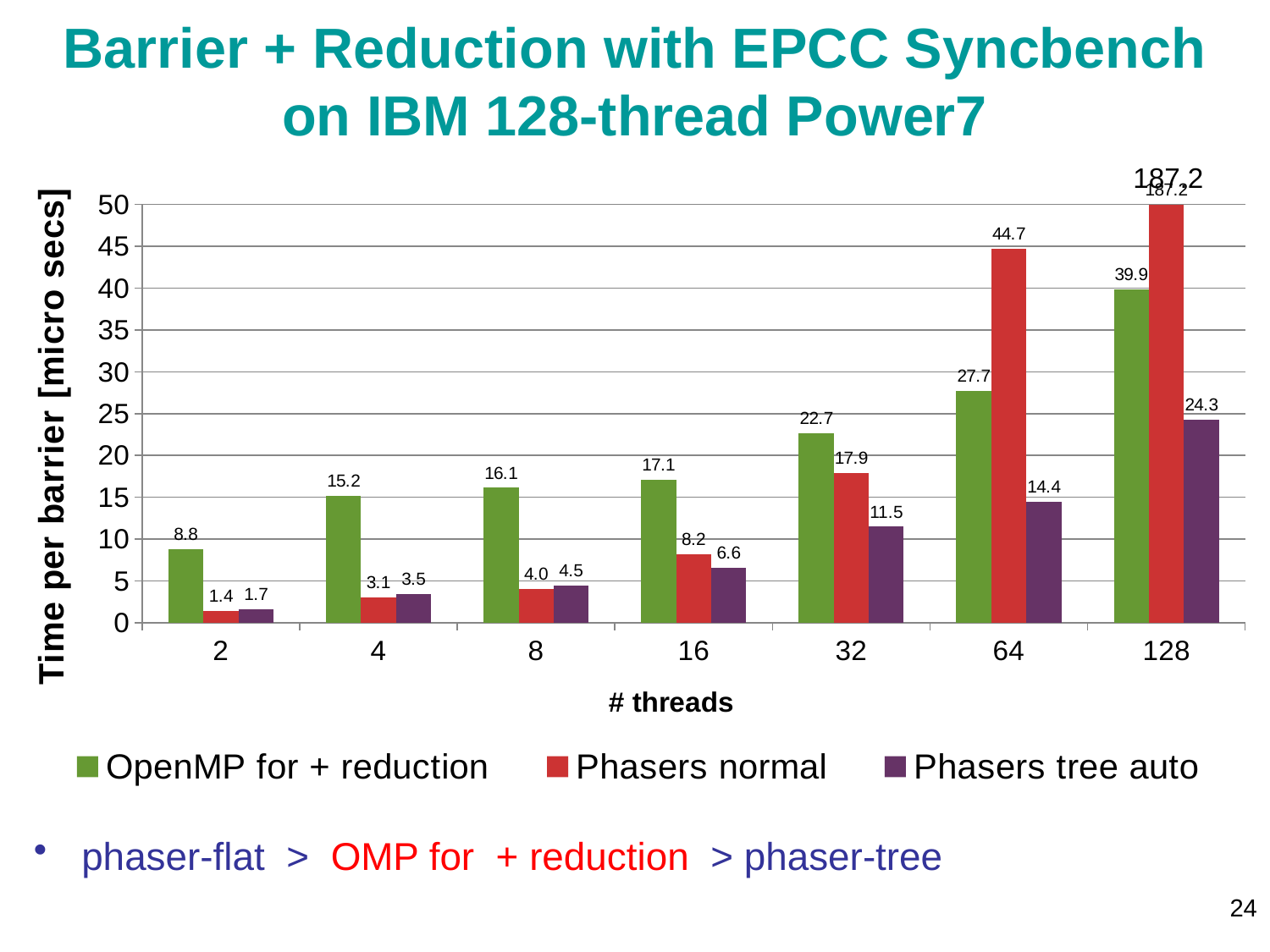
At which number of threads is the OpenMP for + reduction value lowest? 2 What is the value for Phasers tree auto at 64 threads? 14.4 What is the value for Phasers normal at 128 threads? 187.2 What is the difference between the Phasers normal and Phasers tree auto values at 64 threads? 30.3 At 16 threads, which is larger: Phasers normal or Phasers tree auto? Phasers normal How many series does the legend list? 3 At which number of threads is the Phasers tree auto value highest? 128 What is the value for Phasers normal at 8 threads? 4.0 What kind of chart is shown on the slide? Bar chart How many thread counts are shown on the x axis? 7 Do the OpenMP for + reduction values rise or fall as the number of threads increases? Rise What is the value for OpenMP for + reduction at 32 threads? 22.7